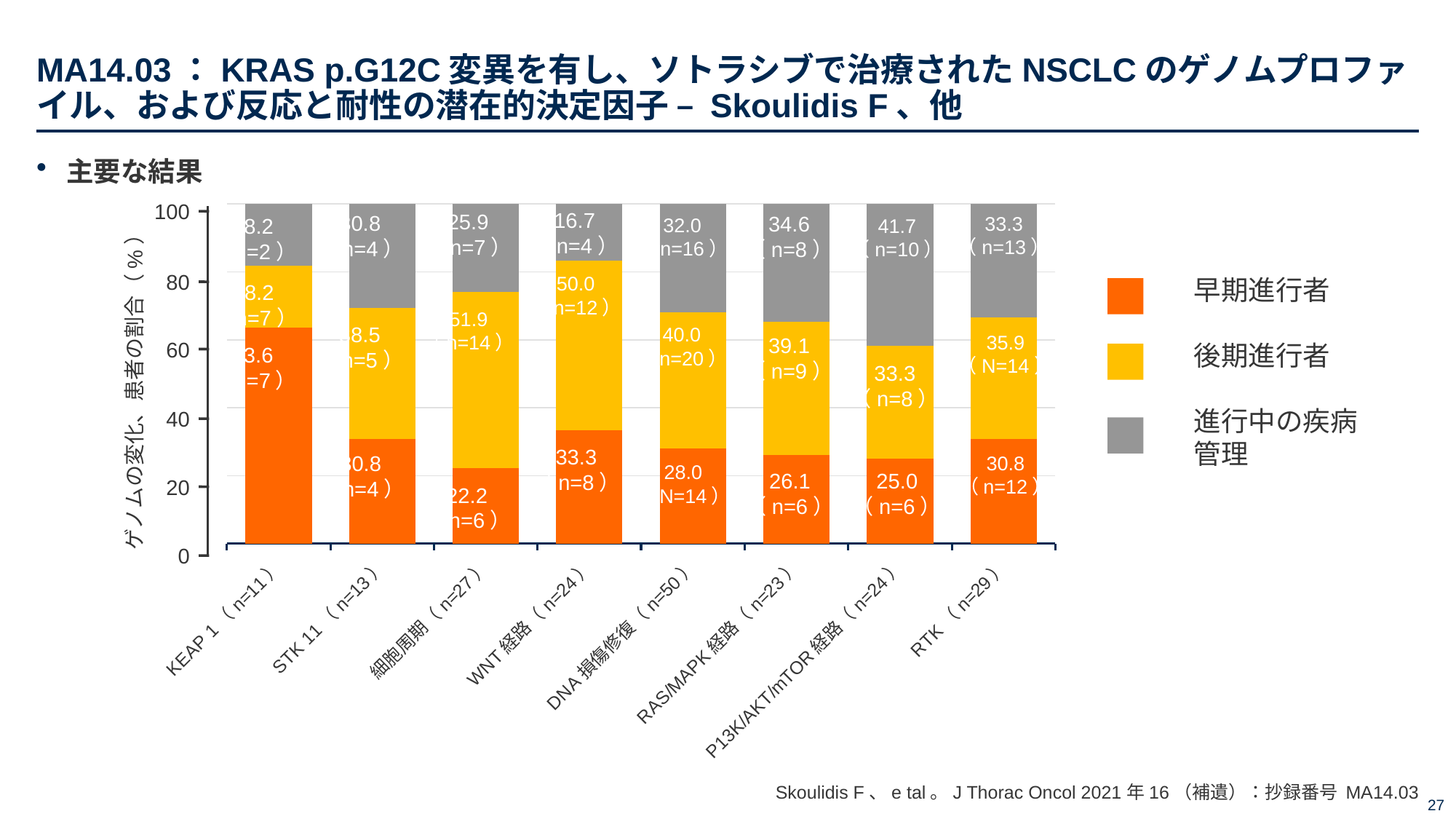
Which legend entry is shown in gray? 進行中の疾病管理 What is the percentage of 進行中の疾病管理 for P13K/AKT/mTOR 経路 (n=24)? 41.7 How many patients (n) are in the 早期進行者 group for RAS/MAPK 経路? n=6 What is the percentage of 早期進行者 for RTK (n=29)? 30.8 How many categories (gene/pathway groups) are shown on the x axis? 8 What is the percentage of 後期進行者 for DNA 損傷修復 (n=50)? 40.0 What is the percentage of 早期進行者 for WNT 経路 (n=24)? 33.3 Which is larger for DNA 損傷修復: the 早期進行者 share or the 進行中の疾病管理 share? 進行中の疾病管理 How many series does the legend list? 3 What is the difference between the 後期進行者 percentage for WNT 経路 and for P13K/AKT/mTOR 経路? 16.7 What is the percentage of 後期進行者 for WNT 経路 (n=24)? 50.0 What kind of chart is shown on the slide? Stacked bar chart